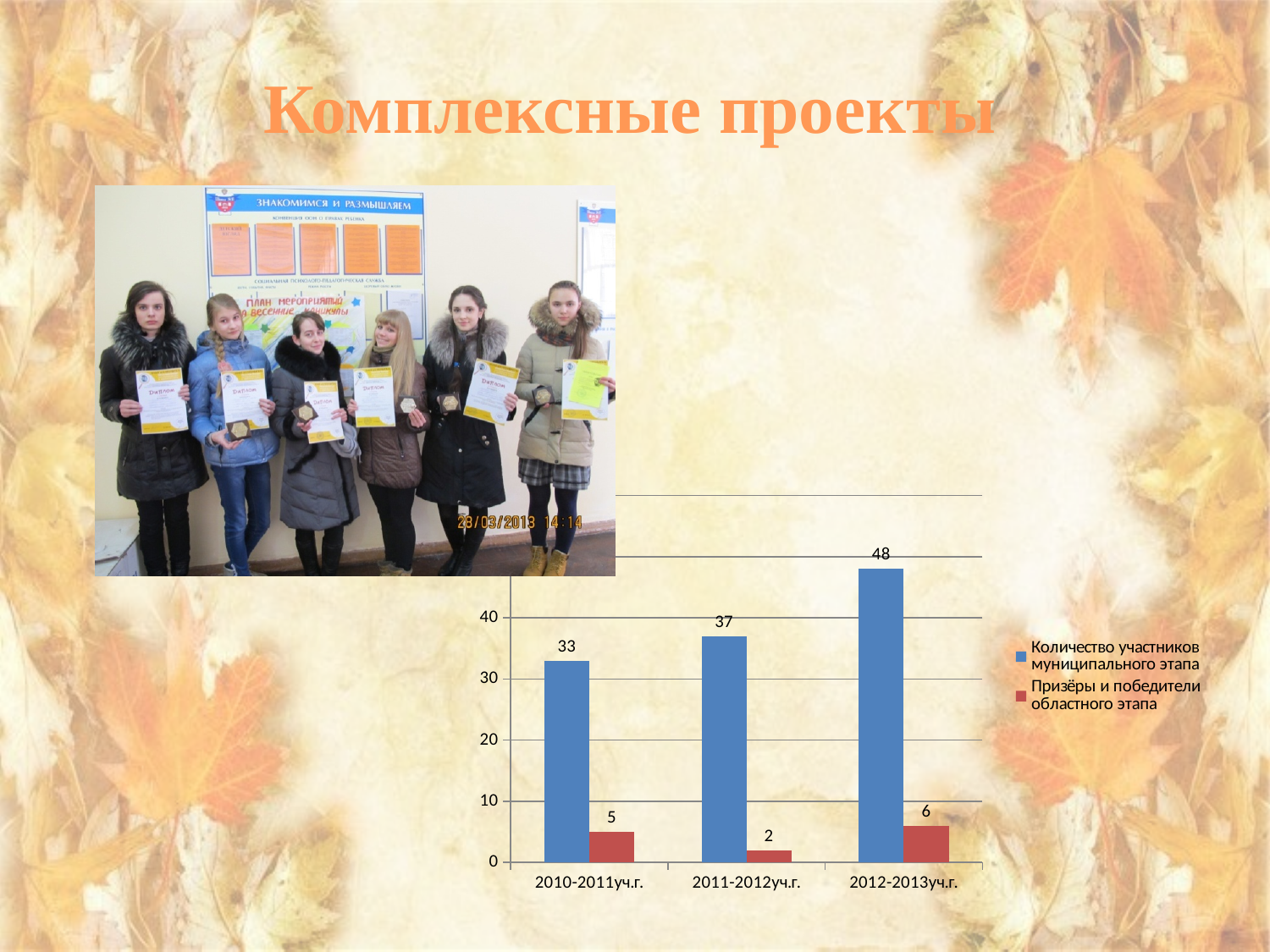
Is the value for 'Количество участников муниципального этапа' in 2011-2012уч.г. greater or less than 40? less How many academic years are shown on the x axis? 3 What is the value for 'Количество участников муниципального этапа' in 2012-2013уч.г.? 48 What is the value for 'Количество участников муниципального этапа' in 2010-2011уч.г.? 33 Which year has the lowest value for 'Призёры и победители областного этапа'? 2011-2012уч.г. What is the difference between 'Количество участников муниципального этапа' in 2012-2013уч.г. and 2011-2012уч.г.? 11 What is the value for 'Призёры и победители областного этапа' in 2011-2012уч.г.? 2 Which is larger: 'Призёры и победители областного этапа' in 2010-2011уч.г. or in 2012-2013уч.г.? 2012-2013уч.г. What kind of chart is shown on the slide? bar chart Does 'Количество участников муниципального этапа' rise or fall from 2010-2011уч.г. to 2012-2013уч.г.? rise Which year has the highest value for 'Количество участников муниципального этапа'? 2012-2013уч.г. How many series does the legend list? 2